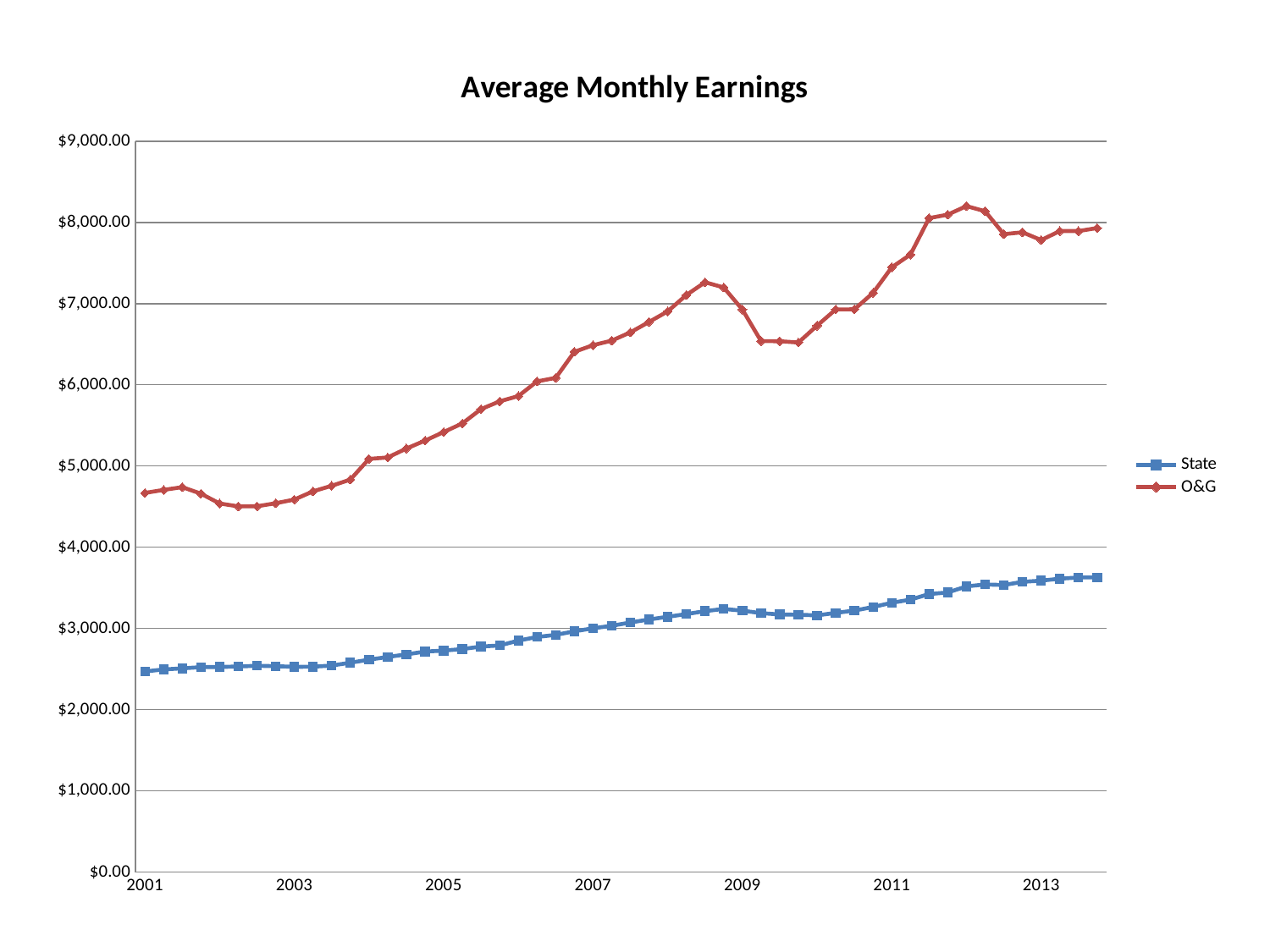
Does the State series generally rise or fall from 2001 to 2013? rise Is the value for State at 2013 greater or less than $4,000.00? less Is the value for O&G at 2013 greater or less than $7,000.00? greater How many series does the legend list? 2 What kind of chart is shown on the slide? line chart Which series has the larger value at 2007, State or O&G? O&G Is the value for State at 2001 greater or less than $3,000.00? less How many year labels are shown on the x axis? 7 What is the title of the chart? Average Monthly Earnings Which series is drawn in red? O&G